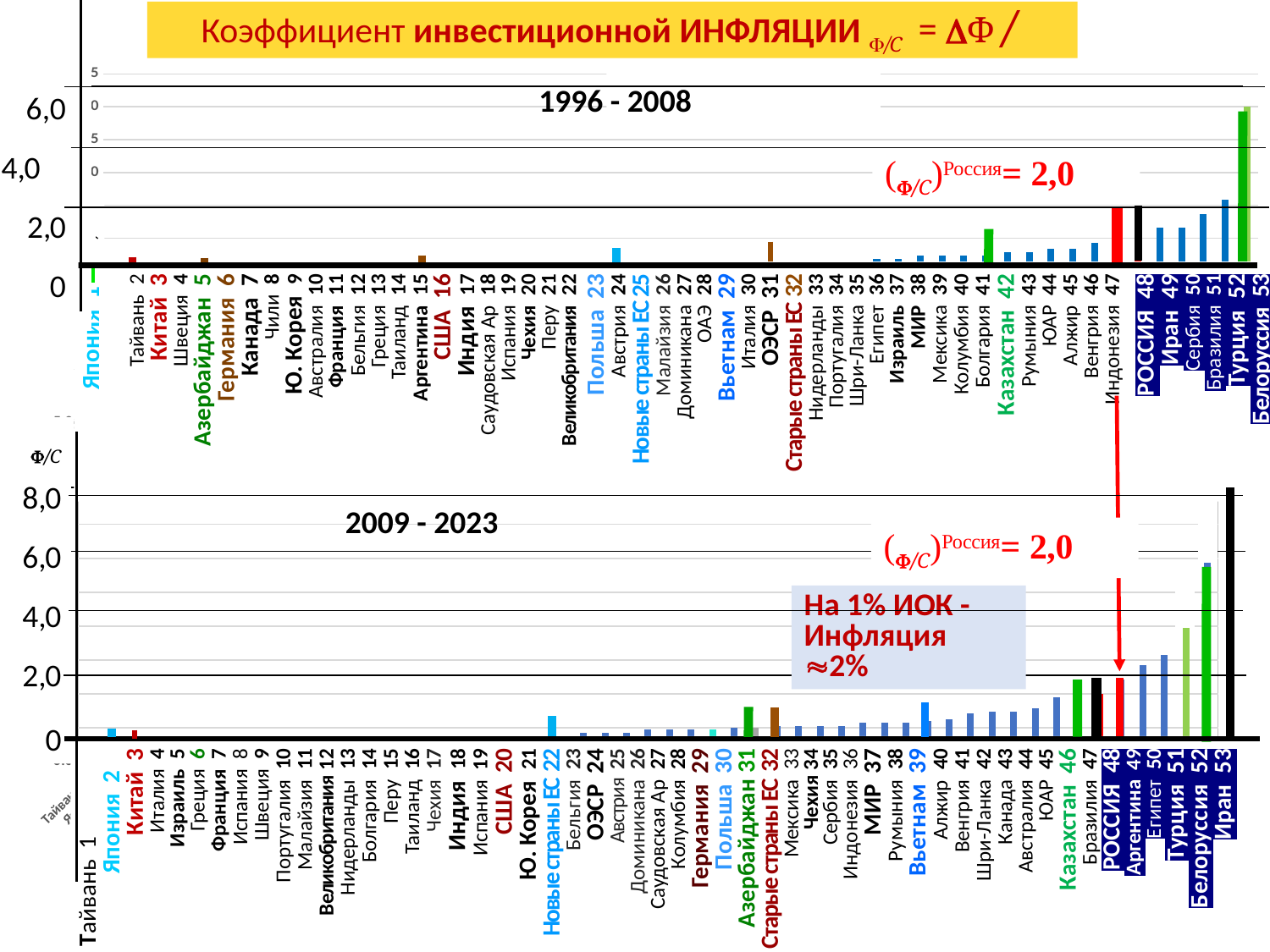
In the "2009 - 2023" chart, is the value for Турция greater or less than 4,0? less In the "1996 - 2008" chart, which is larger, the value for Белоруссия or the value for РОССИЯ? Белоруссия In the "1996 - 2008" chart, which country has the highest bar? Белоруссия In the "2009 - 2023" chart, which country has the highest bar? Иран In the "2009 - 2023" chart, is the value for Иран greater or less than 6,0? greater In the "2009 - 2023" chart, what is the value of the coefficient for РОССИЯ? 2,0 In the "2009 - 2023" chart, do the bar values generally rise or fall from left to right along the x axis? rise What kind of chart is the "1996 - 2008" chart? bar chart How many countries/categories are plotted in the "2009 - 2023" chart? 53 In the "1996 - 2008" chart, what is the value of the coefficient for РОССИЯ? 2,0 In the "2009 - 2023" chart, which is larger, the value for Иран or the value for Белоруссия? Иран In the "1996 - 2008" chart, is the value for Белоруссия greater or less than 4,0? greater